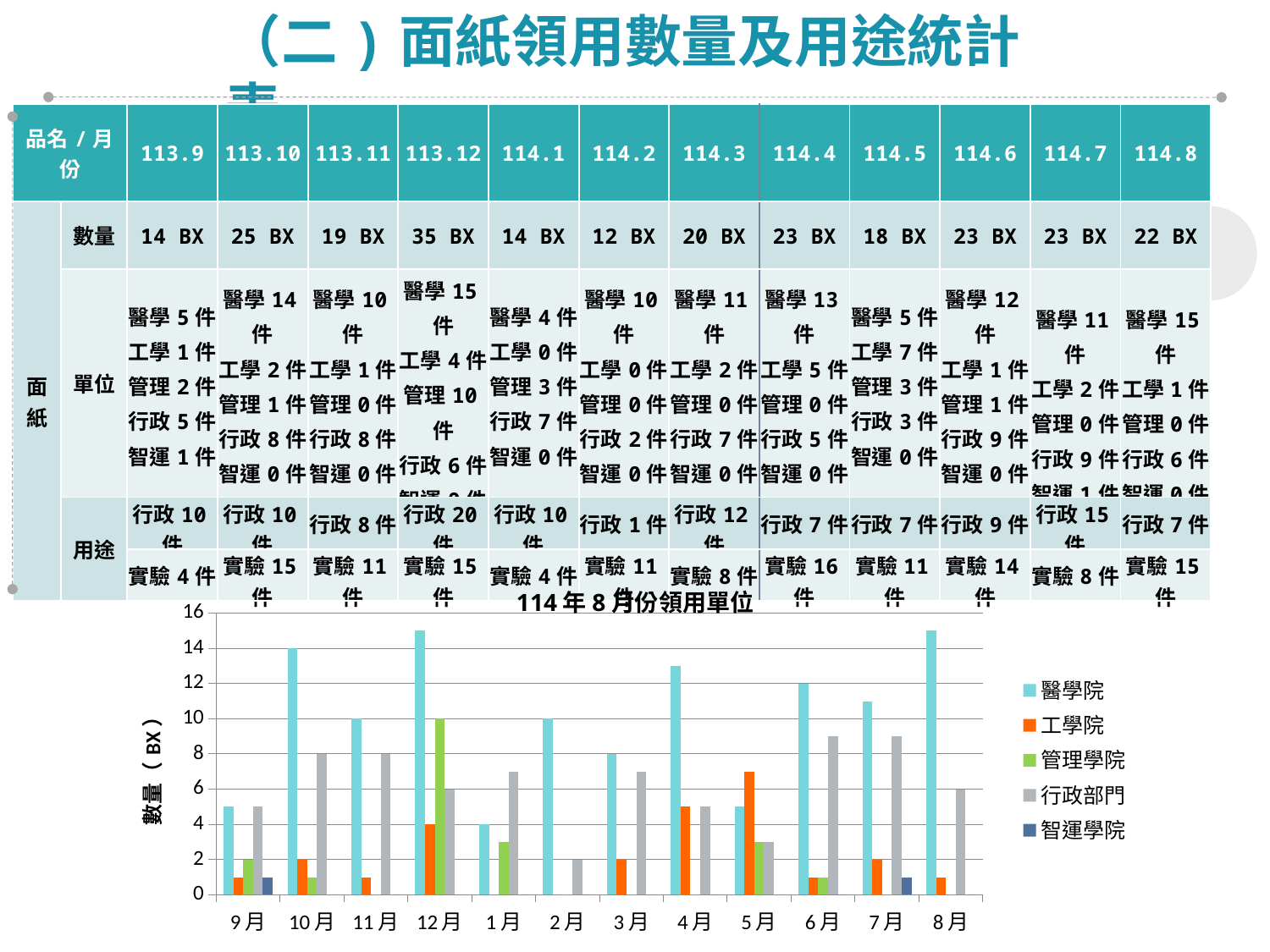
How many series does the legend of the bar chart list? 5 In the bar chart, what is the value for 醫學院 in 10月? 14 How many months are shown along the x axis of the bar chart? 12 In the bar chart, what is the value for 行政部門 in 11月? 8 In the bar chart, is the value for 管理學院 in 1月 greater or less than 4? less In the bar chart, is the value for 醫學院 in 12月 greater or less than 12? greater What kind of chart is shown at the bottom of the slide? bar chart In the bar chart, which is larger in 5月: 工學院 or 行政部門? 工學院 In the bar chart, in which month is the 行政部門 bar lowest? 2月 In the bar chart, what is the difference between 醫學院 and 行政部門 in 10月? 6 What is the title of the bar chart? 114年8月份領用單位 In the bar chart, which series has the highest bar in 12月? 醫學院